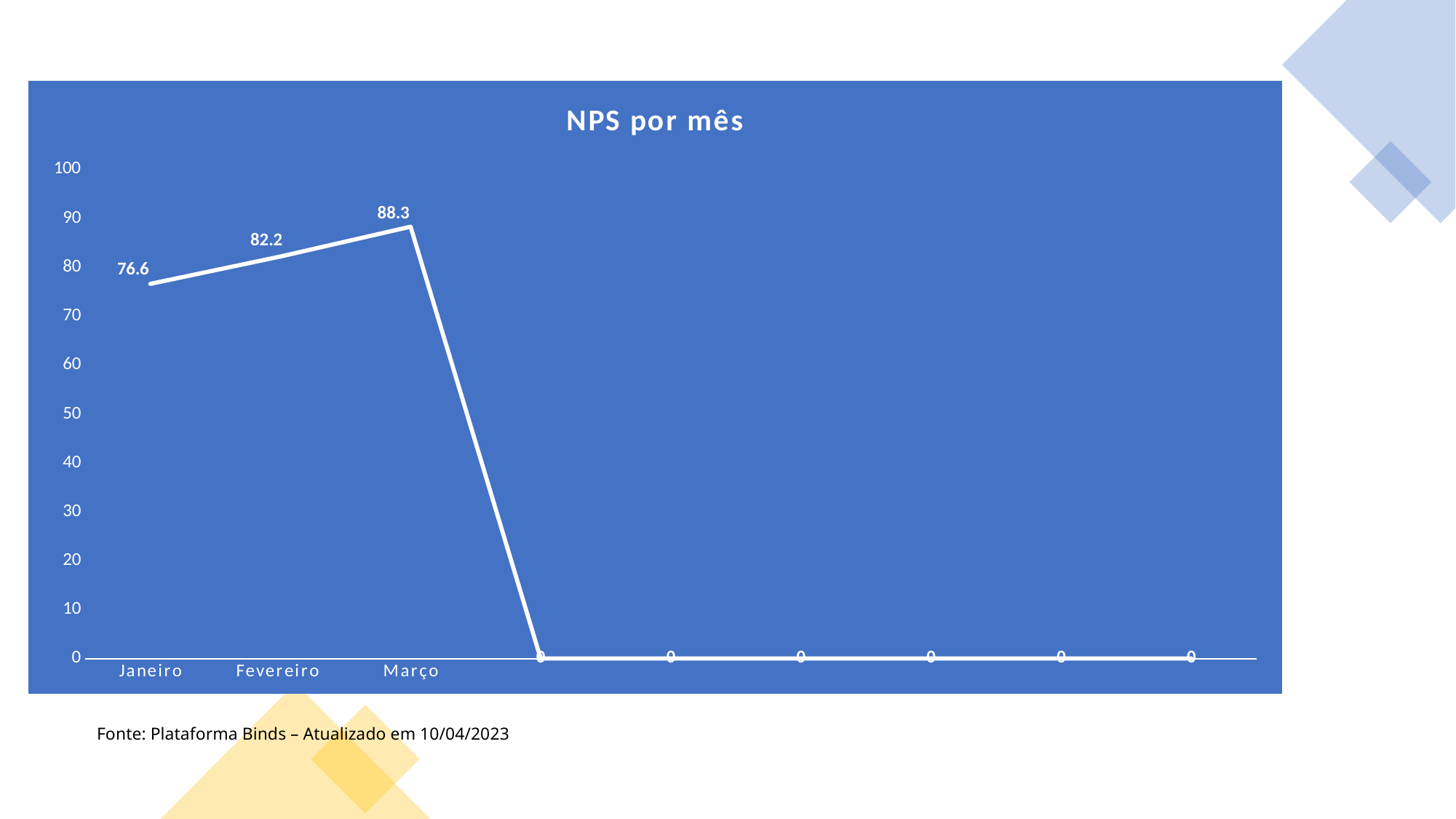
Is the NPS value for Janeiro greater or less than 80? less Among the labeled months, which has the highest NPS? Março What type of chart is shown on the slide? line chart What is the title of the chart? NPS por mês Among the labeled months, which has the lowest NPS? Janeiro What is the NPS value for Março? 88.3 Which month has a higher NPS, Fevereiro or Março? Março How many months are labeled on the x axis? 3 What is the NPS value for Fevereiro? 82.2 What is the difference between the NPS for Fevereiro and the NPS for Janeiro? 5.6 What is the NPS value for Janeiro? 76.6 What is the difference between the NPS for Março and the NPS for Janeiro? 11.7